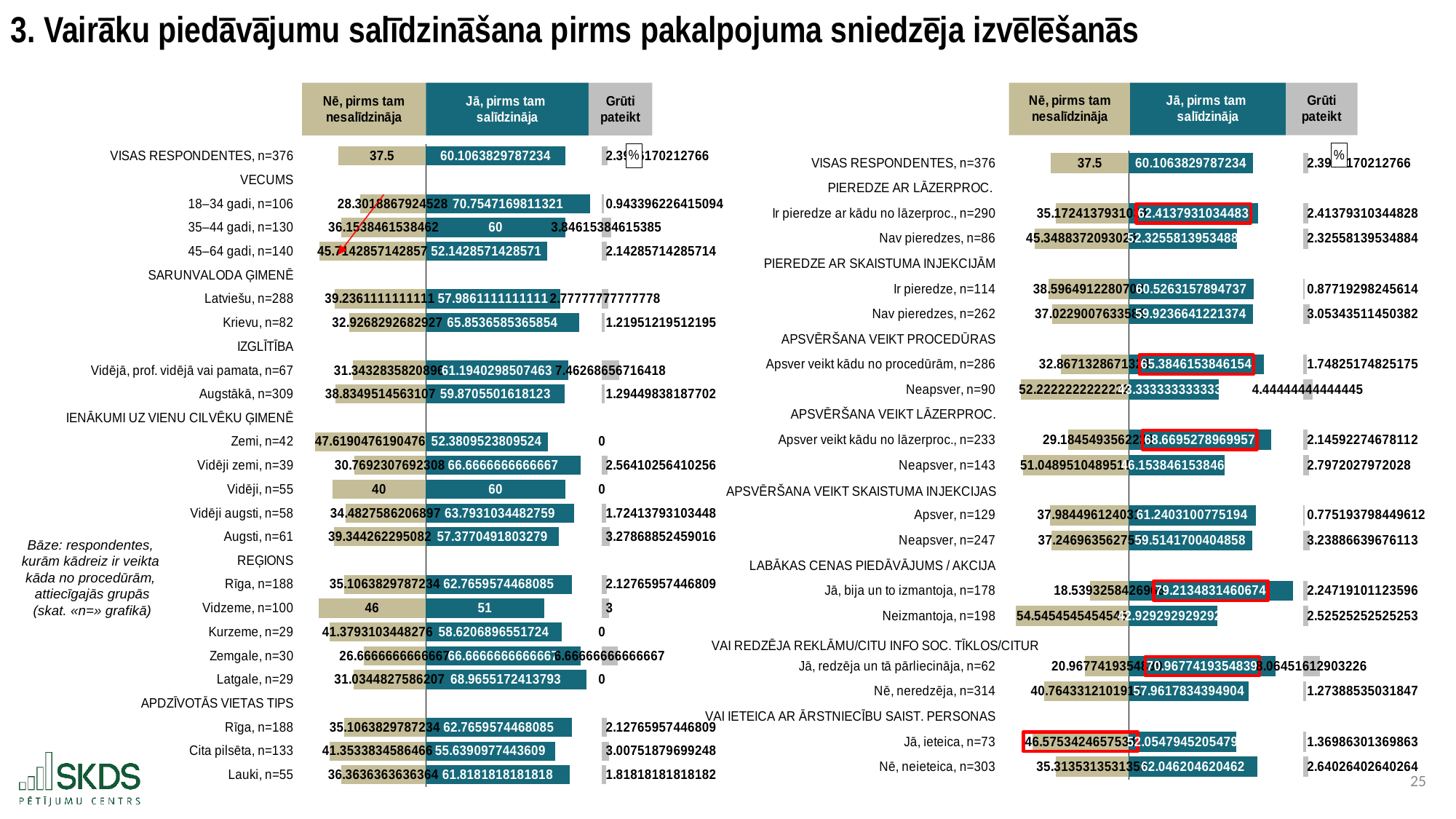
In the left chart, what is the value of "Grūti pateikt" for Vidzeme, n=100? 3 In the left chart, which category has the lowest "Jā, pirms tam salīdzināja" value? Vidzeme, n=100 In the left chart, which has the larger "Jā, pirms tam salīdzināja" value: Vidzeme, n=100 or Latgale, n=29? Latgale, n=29 In the left chart, what is the difference between the "Jā, pirms tam salīdzināja" and "Nē, pirms tam nesalīdzināja" values for Vidzeme, n=100? 5 In the right chart, which category has the highest "Jā, pirms tam salīdzināja" value? Jā, bija un to izmantoja, n=178 In the right chart, what is the value of "Jā, pirms tam salīdzināja" for "Jā, bija un to izmantoja, n=178"? 79.2134831460674 In the left chart, what is the total of the three segments for Vidzeme, n=100? 100 How many series does the legend of the right chart list? 3 In the left chart, what is the value of "Jā, pirms tam salīdzināja" for Vidzeme, n=100? 51 In the right chart, what is the value of "Grūti pateikt" for Neapsver, n=90? 4.44444444444445 In the left chart, what is the value of "Nē, pirms tam nesalīdzināja" for Vidēji, n=55? 40 What kind of chart is the left chart on the slide? bar chart